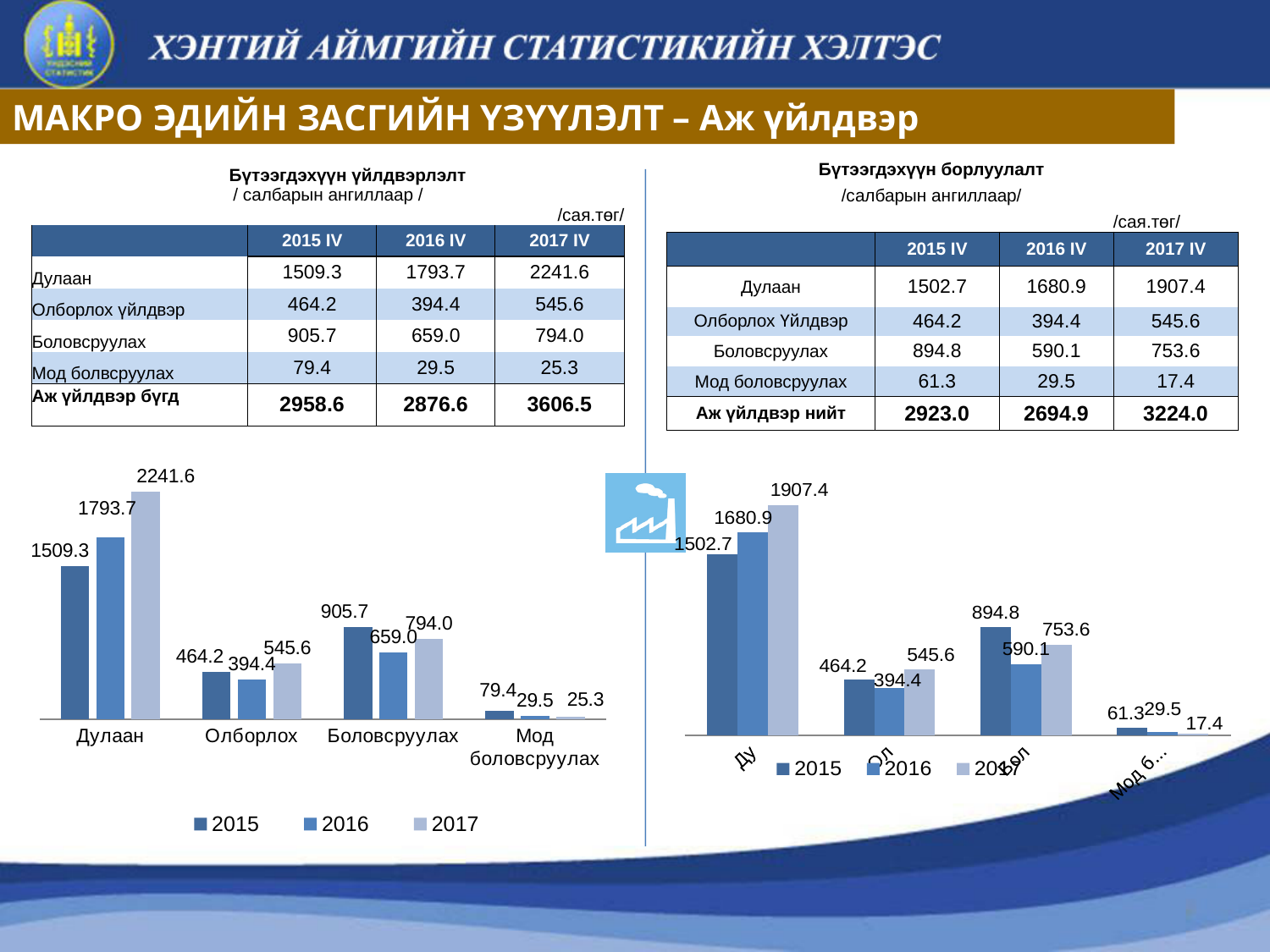
In the left chart (Бүтээгдэхүүн үйлдвэрлэлт), what is the value for Боловсруулах in 2016? 659.0 In the left chart (Бүтээгдэхүүн үйлдвэрлэлт), what is the difference between the 2017 and 2015 values for Дулаан? 732.3 In the right chart (Бүтээгдэхүүн борлуулалт), what is the 2017 value for the first category (Дулаан)? 1907.4 In the left chart (Бүтээгдэхүүн үйлдвэрлэлт), what is the value for Дулаан in 2017? 2241.6 In the left chart (Бүтээгдэхүүн үйлдвэрлэлт), which category has the lowest value in 2017? Мод боловсруулах In the left chart (Бүтээгдэхүүн үйлдвэрлэлт), is the 2015 value for Олборлох larger or smaller than the 2016 value? larger How many series does the legend of the left chart (Бүтээгдэхүүн үйлдвэрлэлт) list? 3 How many categories are shown on the x axis of the left chart (Бүтээгдэхүүн үйлдвэрлэлт)? 4 In the left chart (Бүтээгдэхүүн үйлдвэрлэлт), do the values for Дулаан rise or fall from 2015 to 2017? rise What type of chart is the right chart (Бүтээгдэхүүн борлуулалт)? bar chart In the right chart (Бүтээгдэхүүн борлуулалт), what is the difference between the 2015 and 2016 values for the third category (Боловсруулах)? 304.7 In the left chart (Бүтээгдэхүүн үйлдвэрлэлт), which category has the highest value in 2015? Дулаан